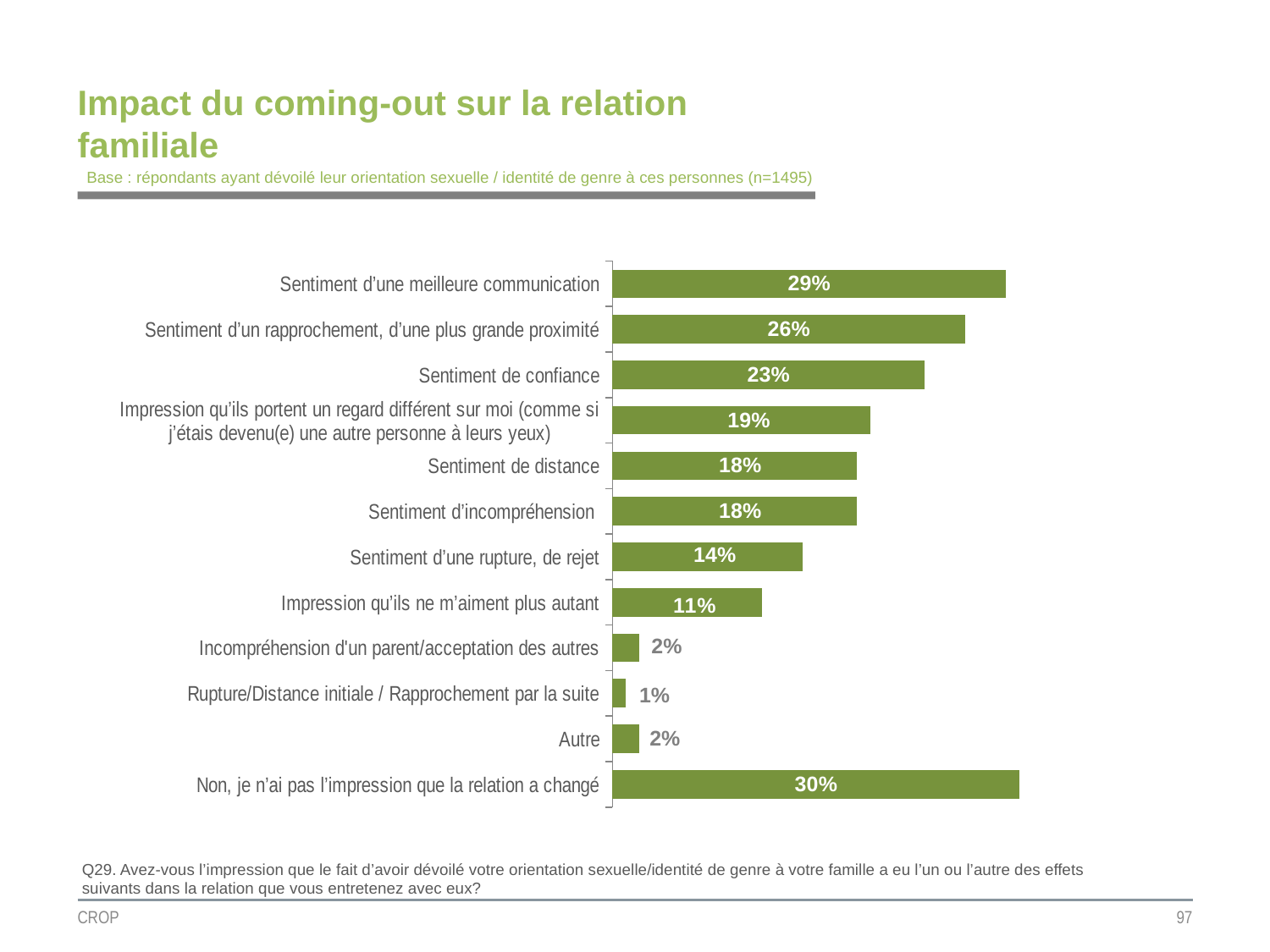
What value is shown for "Impression qu'ils ne m'aiment plus autant"? 11% How many categories are shown in the chart? 12 What is the difference between "Sentiment de distance" and "Sentiment d'une rupture, de rejet"? 4% Which is larger: "Sentiment de confiance" or "Impression qu'ils portent un regard différent sur moi"? Sentiment de confiance What kind of chart is shown on the slide? Bar chart What is the difference between "Sentiment d'une meilleure communication" and "Sentiment d'un rapprochement, d'une plus grande proximité"? 3% Which category has the highest value? Non, je n'ai pas l'impression que la relation a changé Which category has the lowest value? Rupture/Distance initiale / Rapprochement par la suite What value is shown for "Non, je n'ai pas l'impression que la relation a changé"? 30% What value is shown for "Sentiment d'une meilleure communication"? 29% What is the title of the slide? Impact du coming-out sur la relation familiale What value is shown for "Sentiment de confiance"? 23%